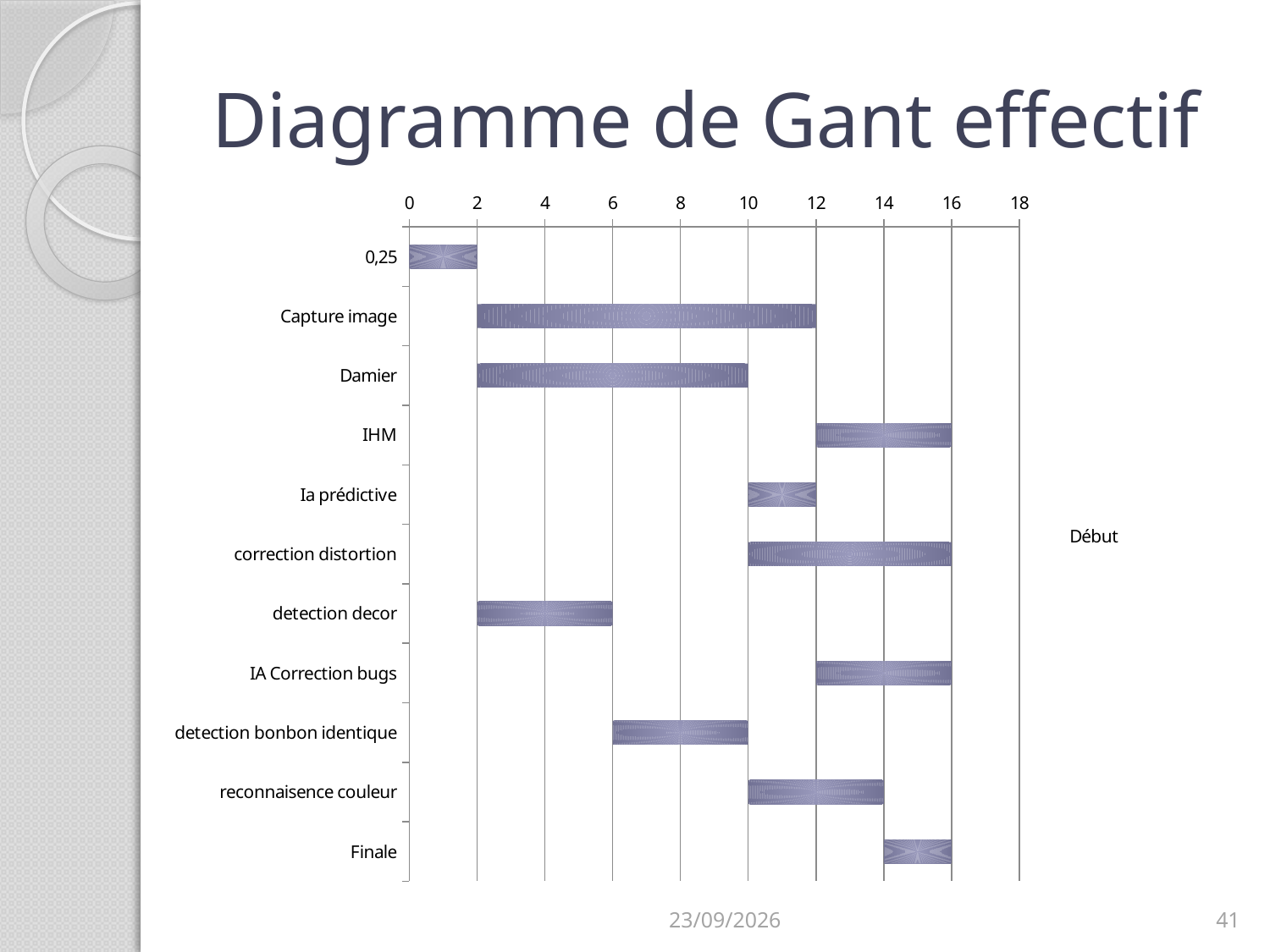
What is the title of the chart? Diagramme de Gant effectif At what value on the horizontal axis does the bar for detection decor end? 6 Is the end of the bar for reconnaisence couleur greater or less than 12? greater What kind of chart is shown on the slide? bar chart How many categories (tasks) are listed on the vertical axis? 11 At what value on the horizontal axis does the bar for Finale start? 14 At what value on the horizontal axis does the bar for Capture image end? 12 Which bar ends later, Damier or Capture image? Capture image How long is the bar for Damier, from its start to its end on the horizontal axis? 8 At what value on the horizontal axis does the bar for IHM start? 12 What legend entry is shown next to the chart? Début Which task has the longest bar? Capture image